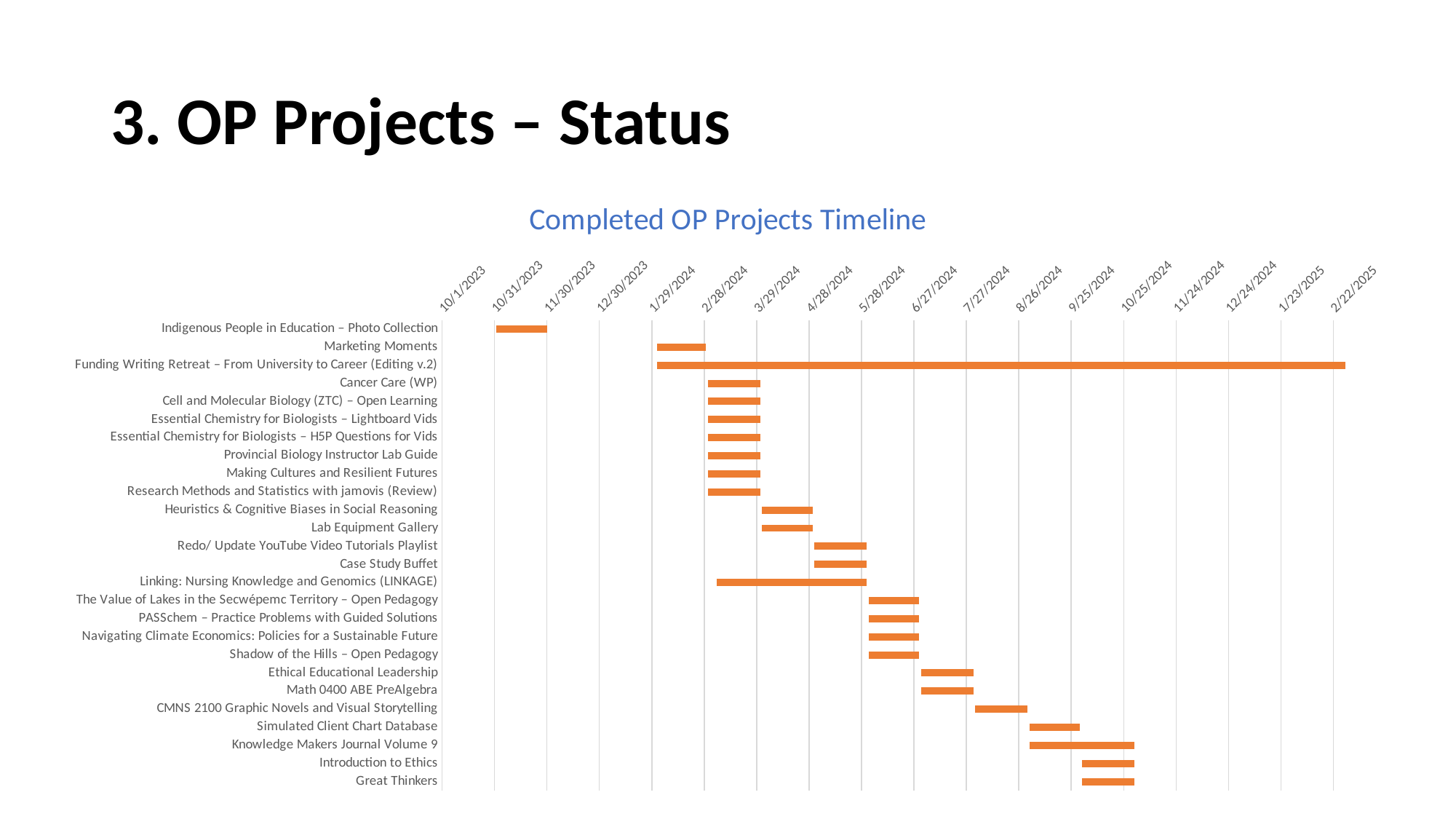
Which bar is longer: Knowledge Makers Journal Volume 9 or Simulated Client Chart Database? Knowledge Makers Journal Volume 9 Which project's bar starts earliest on the timeline? Indigenous People in Education – Photo Collection What kind of chart is shown on the slide? Bar chart (Gantt timeline) Which project has the longest bar on the timeline? Funding Writing Retreat – From University to Career (Editing v.2) How many projects are listed on the chart? 26 What is the title of the chart? Completed OP Projects Timeline Which bar is longer: Linking: Nursing Knowledge and Genomics (LINKAGE) or Case Study Buffet? Linking: Nursing Knowledge and Genomics (LINKAGE) Which project is listed last (at the bottom) on the chart? Great Thinkers